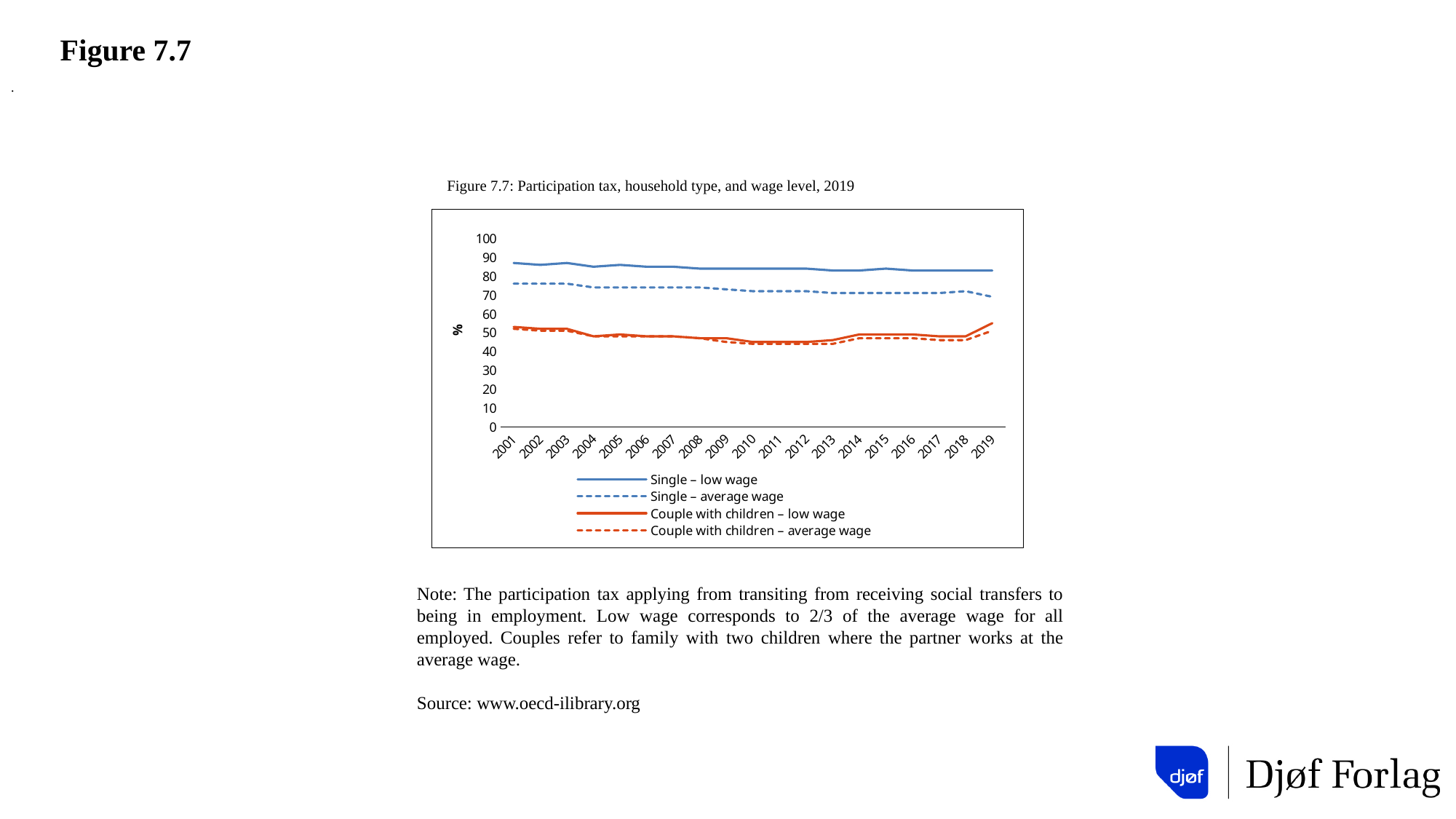
Does the Single – average wage series rise or fall from 2001 to 2019? Fall What is the label on the y axis? % What kind of chart is shown on the slide? Line chart How many years are shown along the x axis? 19 Is the value for Couple with children – low wage in 2010 greater or less than 50? less How many series does the legend list? 4 Is the value for Single – low wage in 2001 greater or less than 80? greater In 2010, which is larger: Single – low wage or Couple with children – low wage? Single – low wage Is the value for Single – average wage in 2019 greater or less than 80? less What is the title of the chart? Figure 7.7: Participation tax, household type, and wage level, 2019 Which series has the highest value in 2019? Single – low wage